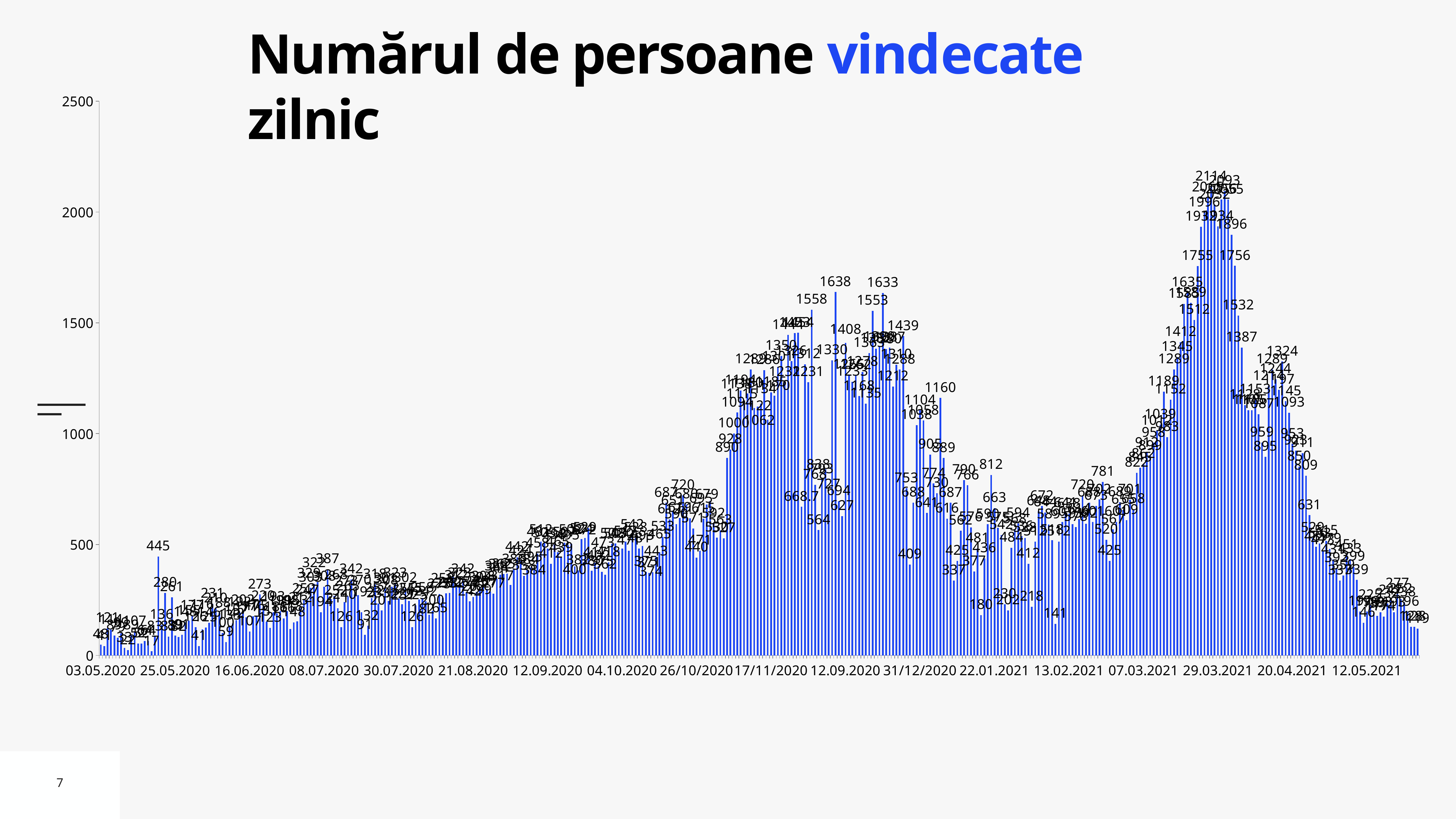
Is the value for 29.03.2021 greater or less than 1500? greater Do the values rise or fall between 13.02.2021 and 29.03.2021? rise What is the highest value shown on the vertical axis? 2500 What is the last date label on the horizontal axis? 12.05.2021 What is the highest value labeled on the chart? 2114 Is the value for 12.05.2021 greater or less than 500? less Is the value for 13.02.2021 greater or less than 1000? less What is the first date label on the horizontal axis? 03.05.2020 What is the title of the chart? Numărul de persoane vindecate zilnic Which peak is higher: the one around 29.03.2021 or the one around 17/11/2020? 29.03.2021 What kind of chart is shown on the slide? bar chart